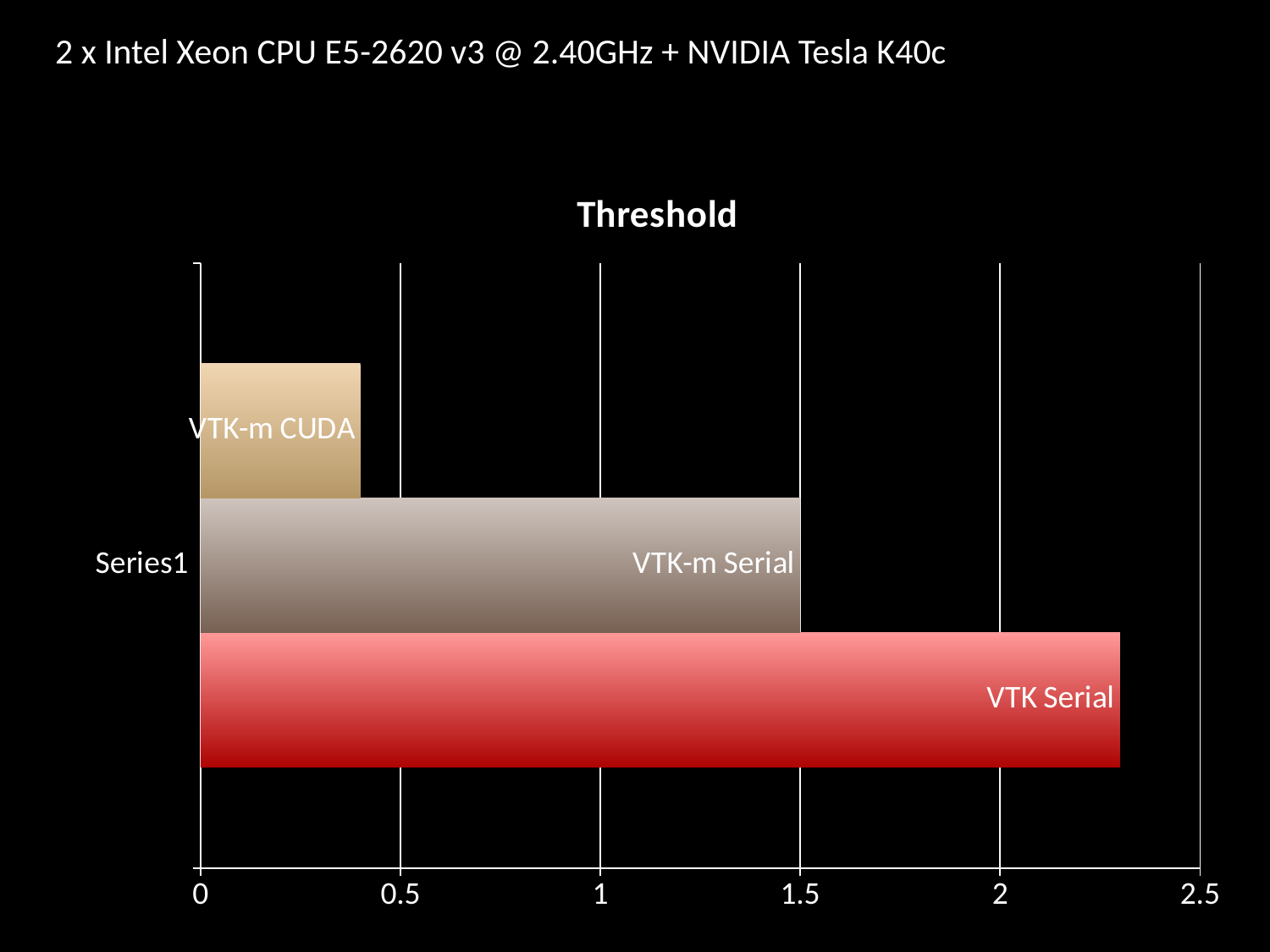
Which is larger, the value for VTK-m Serial or the value for VTK-m CUDA? VTK-m Serial How many bars are plotted in the chart? 3 Which bar is the shortest in the chart? VTK-m CUDA Which bar is the longest in the chart? VTK Serial Is the value for VTK-m CUDA greater or less than 0.5? less Is the value for VTK Serial greater or less than 2? greater What is the category label shown on the vertical axis of the chart? Series1 Is the value for VTK-m Serial greater or less than 1? greater What is the title of the chart? Threshold What kind of chart is shown on the slide? bar chart Which is larger, the value for VTK Serial or the value for VTK-m Serial? VTK Serial